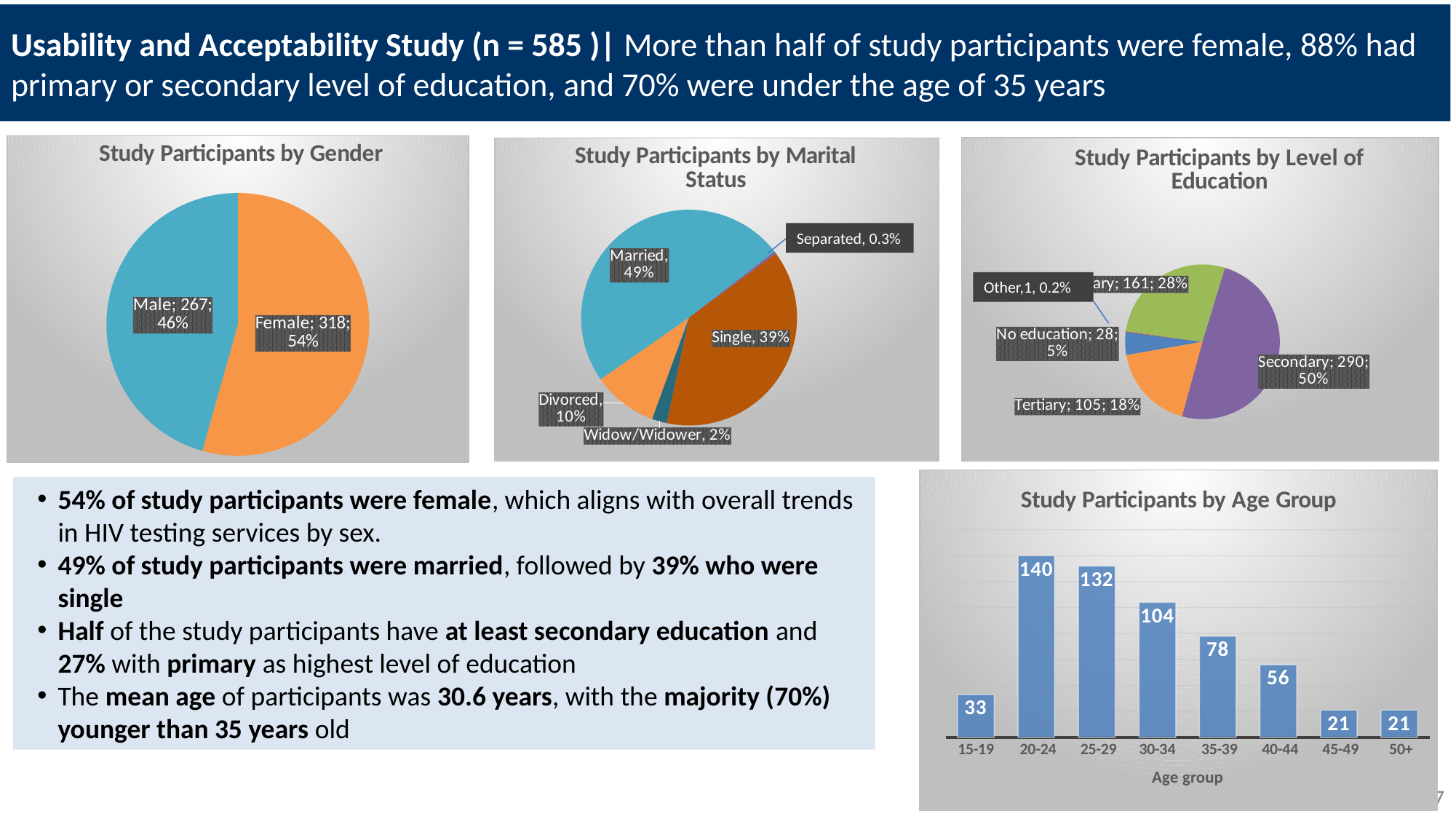
In the Study Participants by Marital Status chart, what percentage of participants were married? 49% In the Study Participants by Gender chart, what share of participants were male? 46% What kind of chart is Study Participants by Age Group? Bar chart In the Study Participants by Marital Status chart, how many marital status categories are shown? 5 In the Study Participants by Gender chart, how many participants were female? 318 In the Study Participants by Age Group chart, what is the difference between the 20-24 and 25-29 age groups? 8 In the Study Participants by Level of Education chart, what share of participants had tertiary education? 18% In the Study Participants by Age Group chart, how many age groups are shown? 8 In the Study Participants by Marital Status chart, which marital status has the smallest share? Separated In the Study Participants by Gender chart, how many more female than male participants were there? 51 In the Study Participants by Age Group chart, which age group has the most participants? 20-24 In the Study Participants by Level of Education chart, how many participants had secondary education? 290